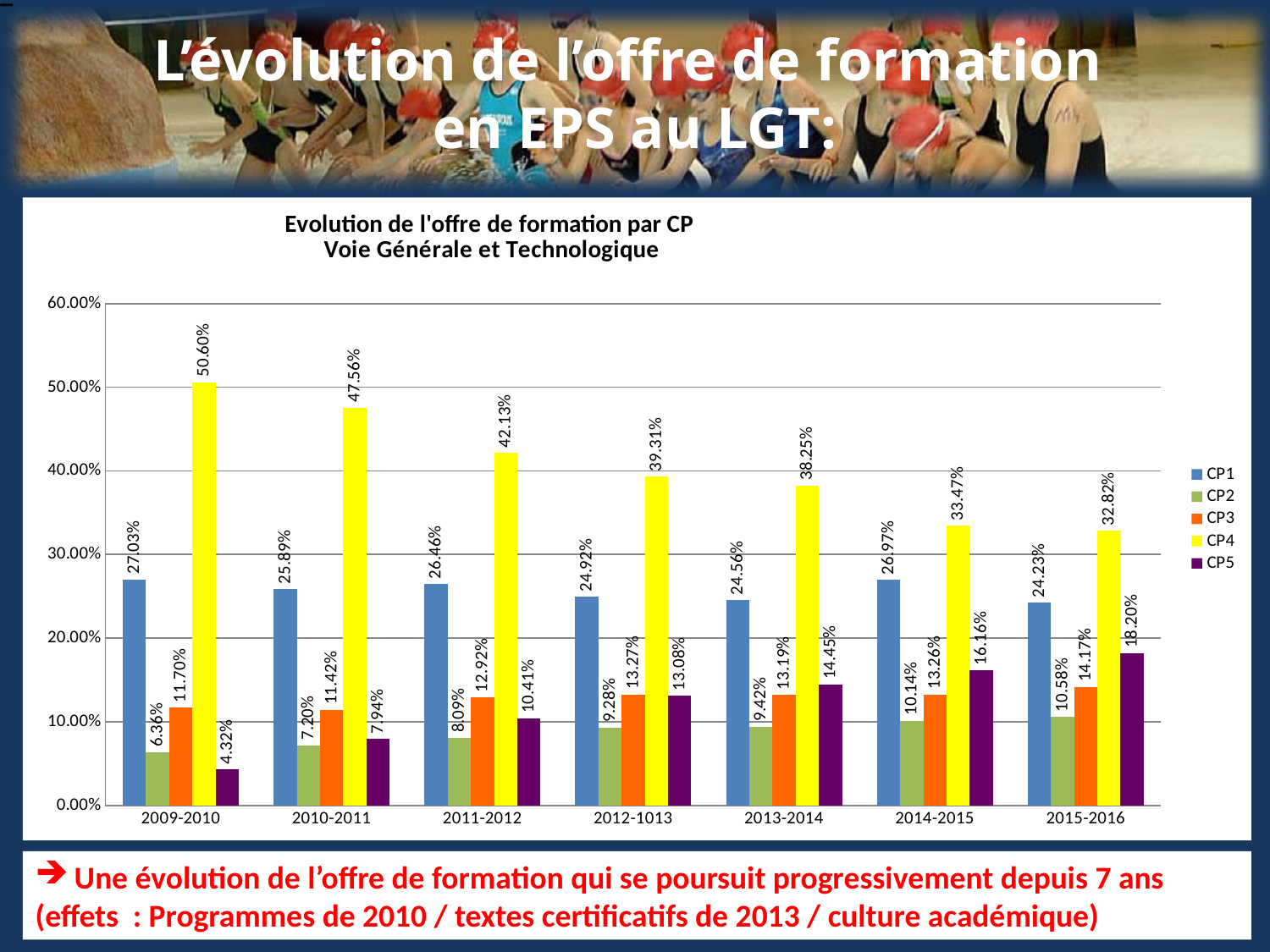
In which year is the CP5 value lowest? 2009-2010 What kind of chart is shown on the slide? bar chart Does the CP5 value rise or fall from 2009-2010 to 2015-2016? rise What is the difference between the CP4 values for 2009-2010 and 2015-2016? 17.78% What is the value for CP1 in 2014-2015? 26.97% How many year categories are shown on the x axis? 7 What is the value for CP5 in 2015-2016? 18.20% Is the value for CP4 in 2011-2012 greater or less than 40.00%? greater In which year is the CP4 value highest? 2009-2010 Which is larger in 2013-2014, CP1 or CP5? CP1 How many series does the legend list? 5 What is the value for CP4 in 2009-2010? 50.60%